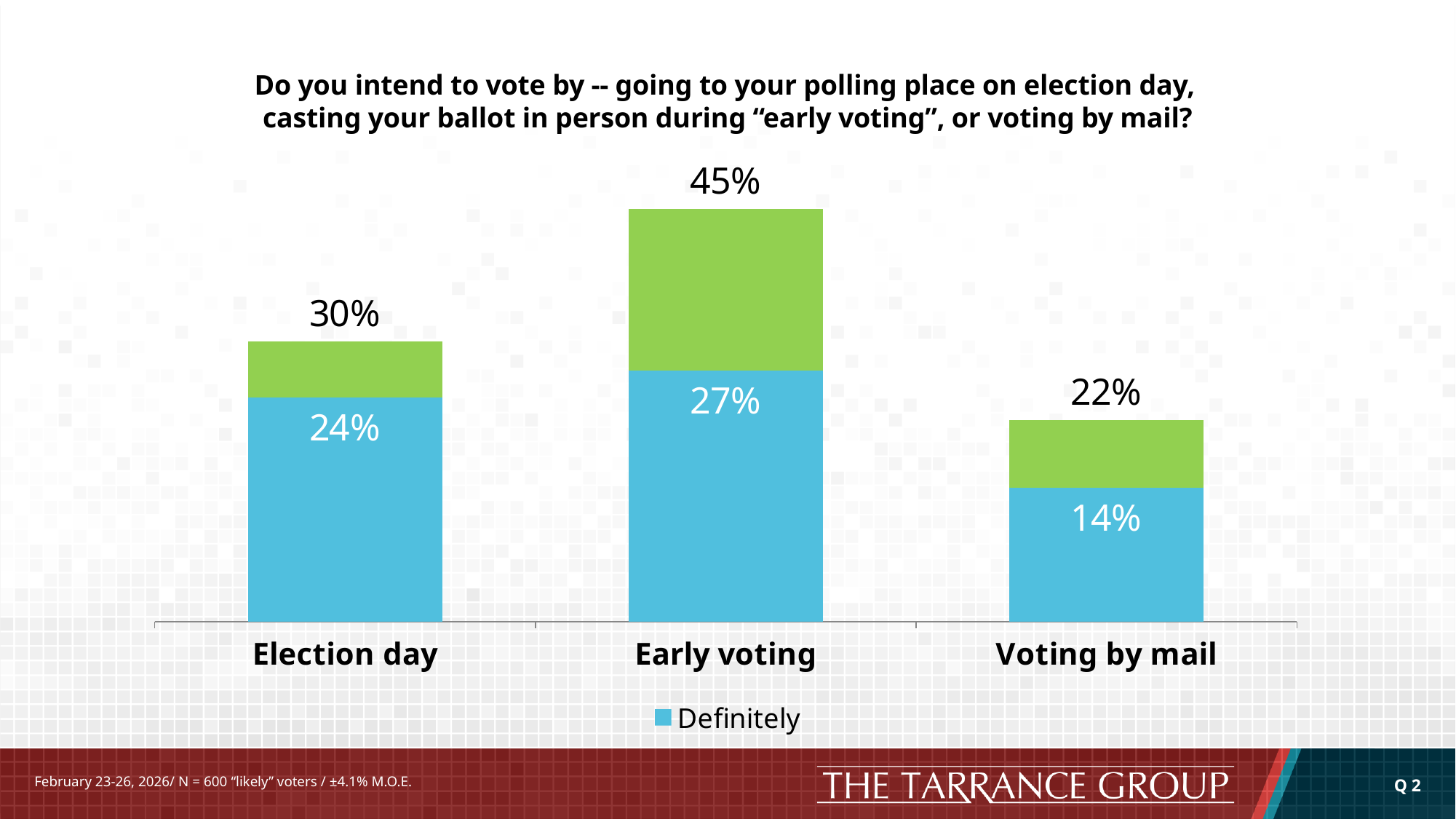
Which category has the highest total? Early voting What is the difference between the total for Early voting and the total for Election day? 15% What entry does the legend list? Definitely How many categories are shown on the x axis? 3 What is the total value shown above the Voting by mail bar? 22% Which category has the lowest Definitely value? Voting by mail What is the Definitely value for Election day? 24% What is the total value shown above the Early voting bar? 45% What is the Definitely value for Voting by mail? 14% What kind of chart is shown on the slide? Stacked bar chart Which is larger, the total for Election day or the total for Voting by mail? Election day What is the difference between the Definitely values for Early voting and Voting by mail? 13%